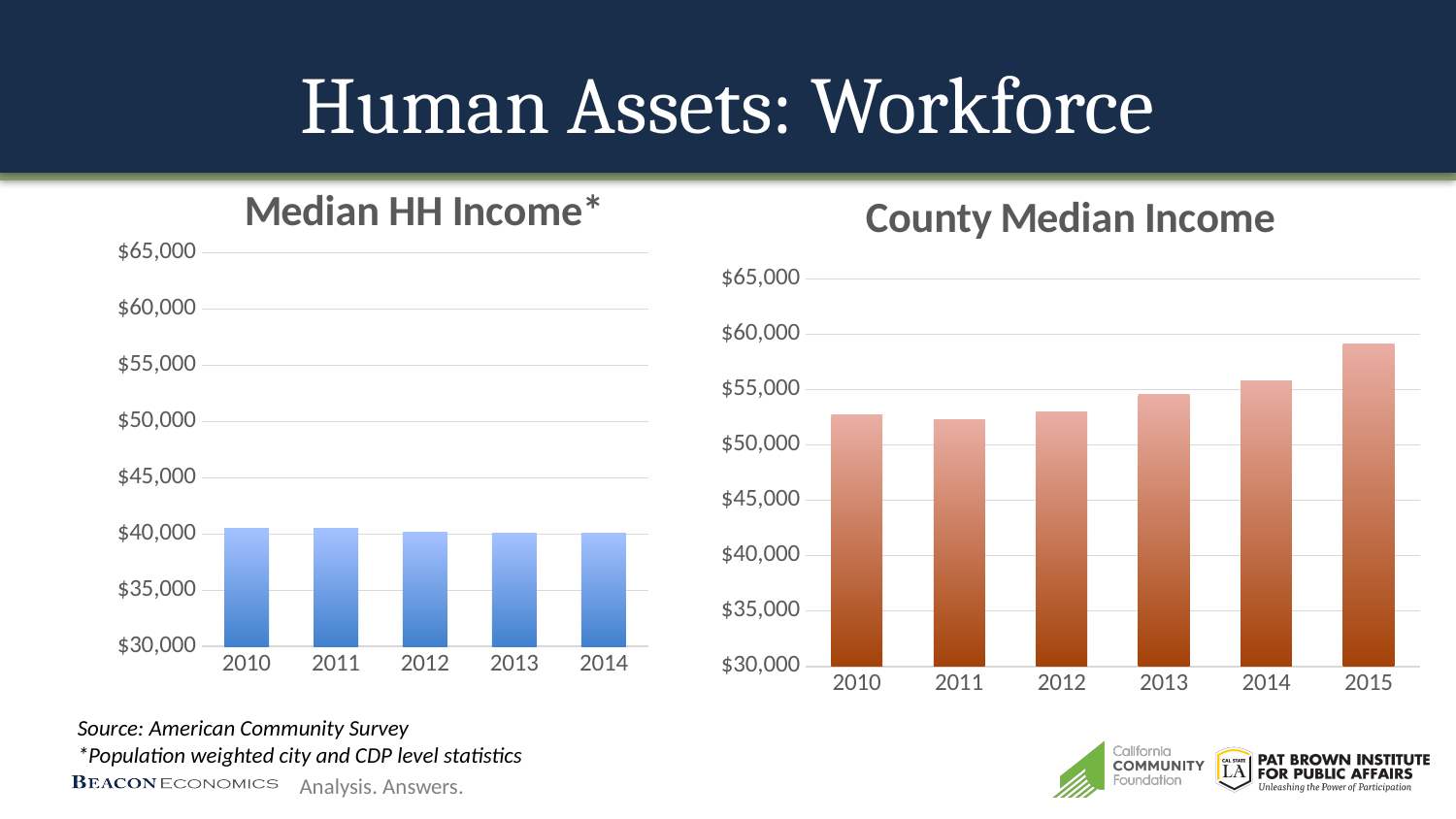
In the County Median Income chart, do the values generally rise or fall from 2011 to 2015? rise In the Median HH Income* chart, is the value for 2012 greater or less than $45,000? less How many years are shown on the County Median Income chart? 6 In the County Median Income chart, is the value for 2010 greater or less than $50,000? greater In the County Median Income chart, which year has the highest value? 2015 What is the title of the chart on the left side of the slide? Median HH Income* In the County Median Income chart, which is larger, the value for 2010 or the value for 2015? 2015 In the County Median Income chart, is the value for 2015 greater or less than $55,000? greater How many years are shown on the Median HH Income* chart? 5 What kind of chart is the County Median Income chart? bar chart